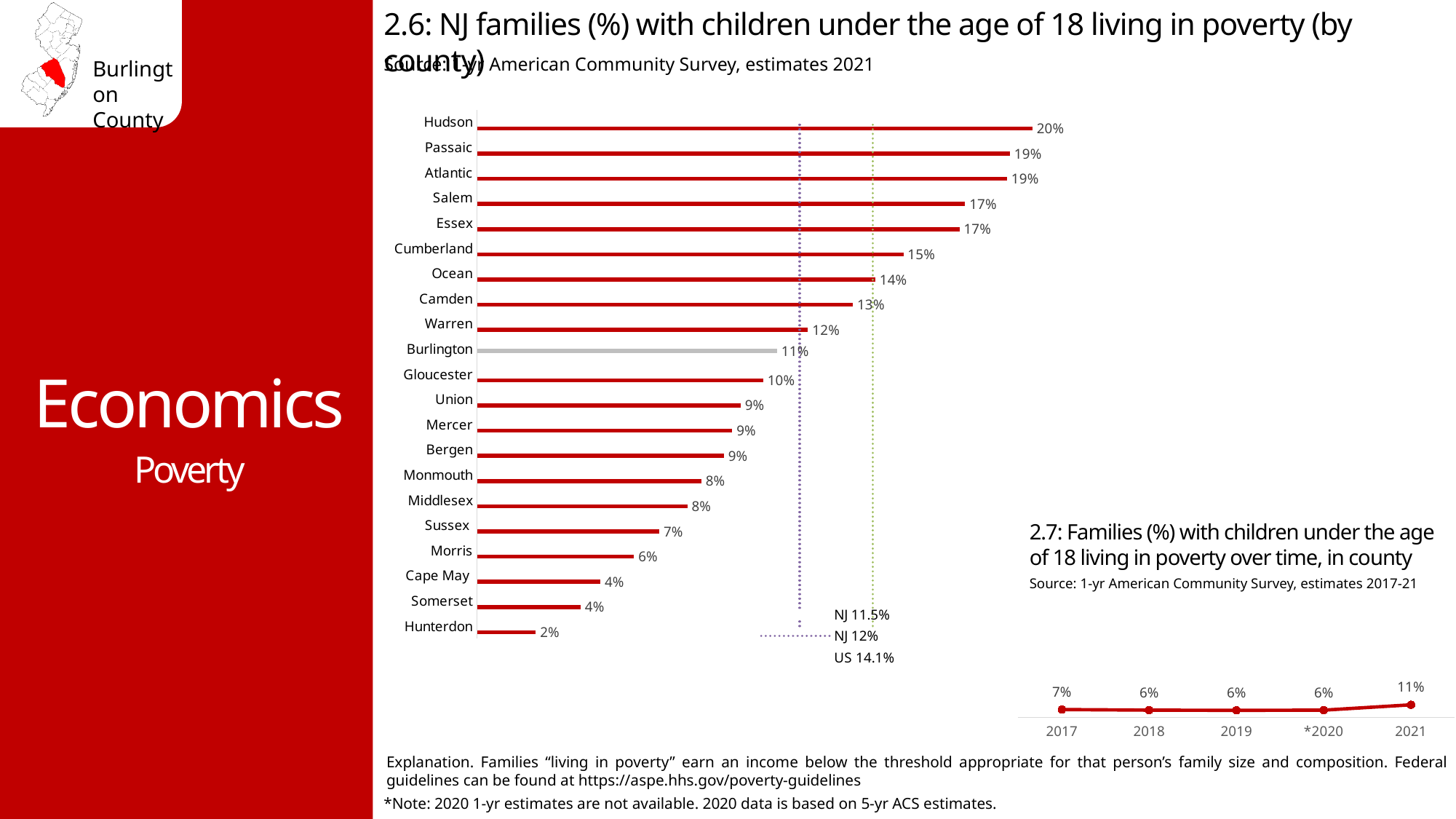
In chart 2.6, what is the difference between the values for Hudson and Hunterdon? 18% In chart 2.7, what is the difference between the values for 2021 and 2020? 5% In chart 2.6, which county has the highest percentage of families with children living in poverty? Hudson In chart 2.6, which county has the lowest percentage of families with children living in poverty? Hunterdon In chart 2.6, what is the value for Cumberland? 15% In chart 2.6, what US value is marked by the reference line? 14.1% In chart 2.6 (NJ families with children under 18 living in poverty by county), what is the value for Burlington? 11% In chart 2.6, which is larger, the value for Camden or the value for Gloucester? Camden What kind of chart is chart 2.7? Line chart What kind of chart is chart 2.6? Bar chart In chart 2.7 (families with children under 18 living in poverty over time, in county), what is the value for 2021? 11% In chart 2.6, how many counties are plotted? 21